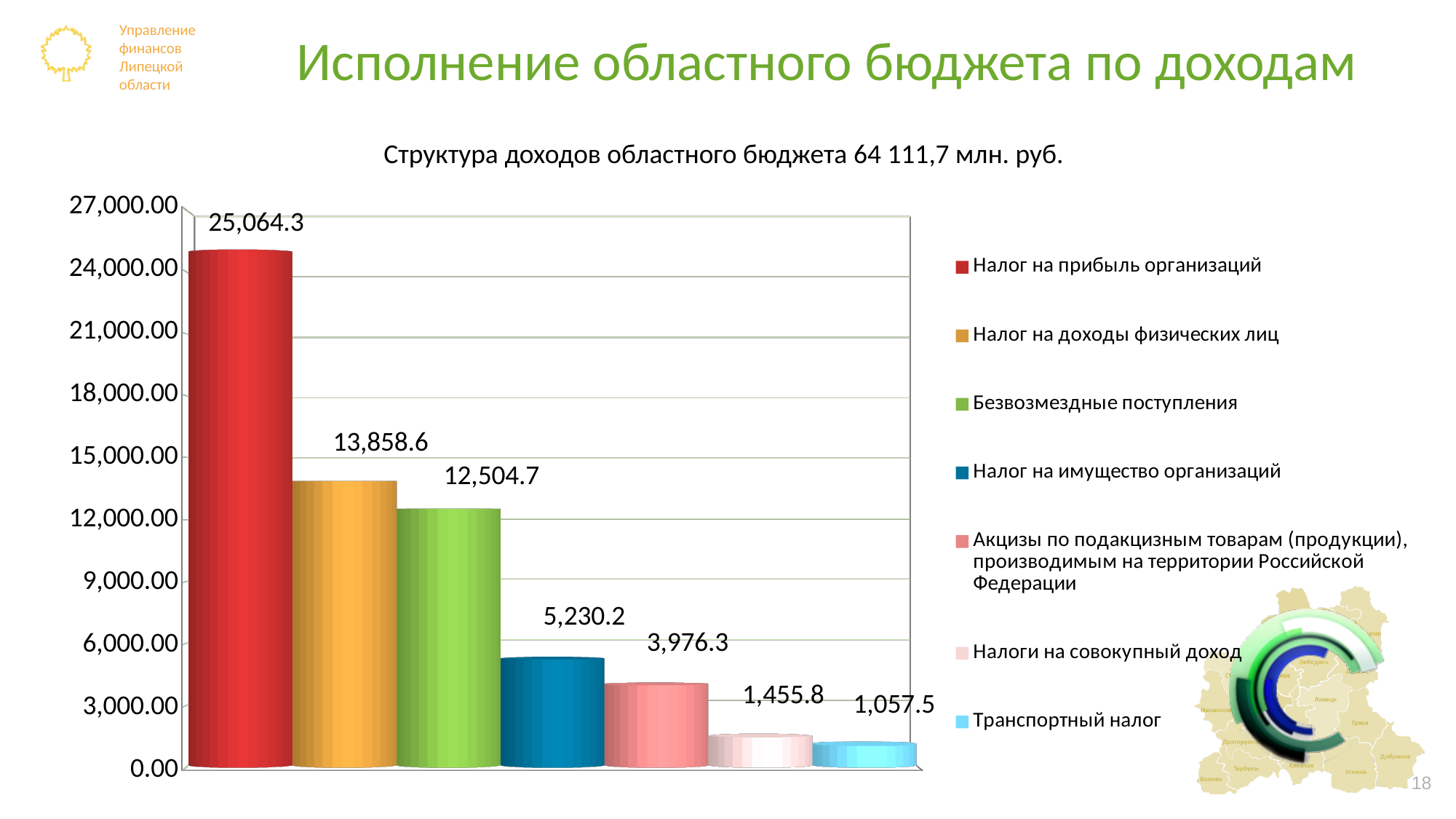
What is the value for Налог на прибыль организаций? 25,064.3 Is the value for Налог на имущество организаций greater or less than 6,000.00? less Which is larger: Налог на имущество организаций or Налоги на совокупный доход? Налог на имущество организаций How many bars are plotted in the chart? 7 What is the difference between Налог на прибыль организаций and Налог на доходы физических лиц? 11,205.7 Which category has the highest value? Налог на прибыль организаций What is the title of the chart? Структура доходов областного бюджета 64 111,7 млн. руб. What kind of chart is shown on the slide? bar chart What is the value for Транспортный налог? 1,057.5 Which category has the lowest value? Транспортный налог What is the value for Безвозмездные поступления? 12,504.7 What is the value for Налог на доходы физических лиц? 13,858.6